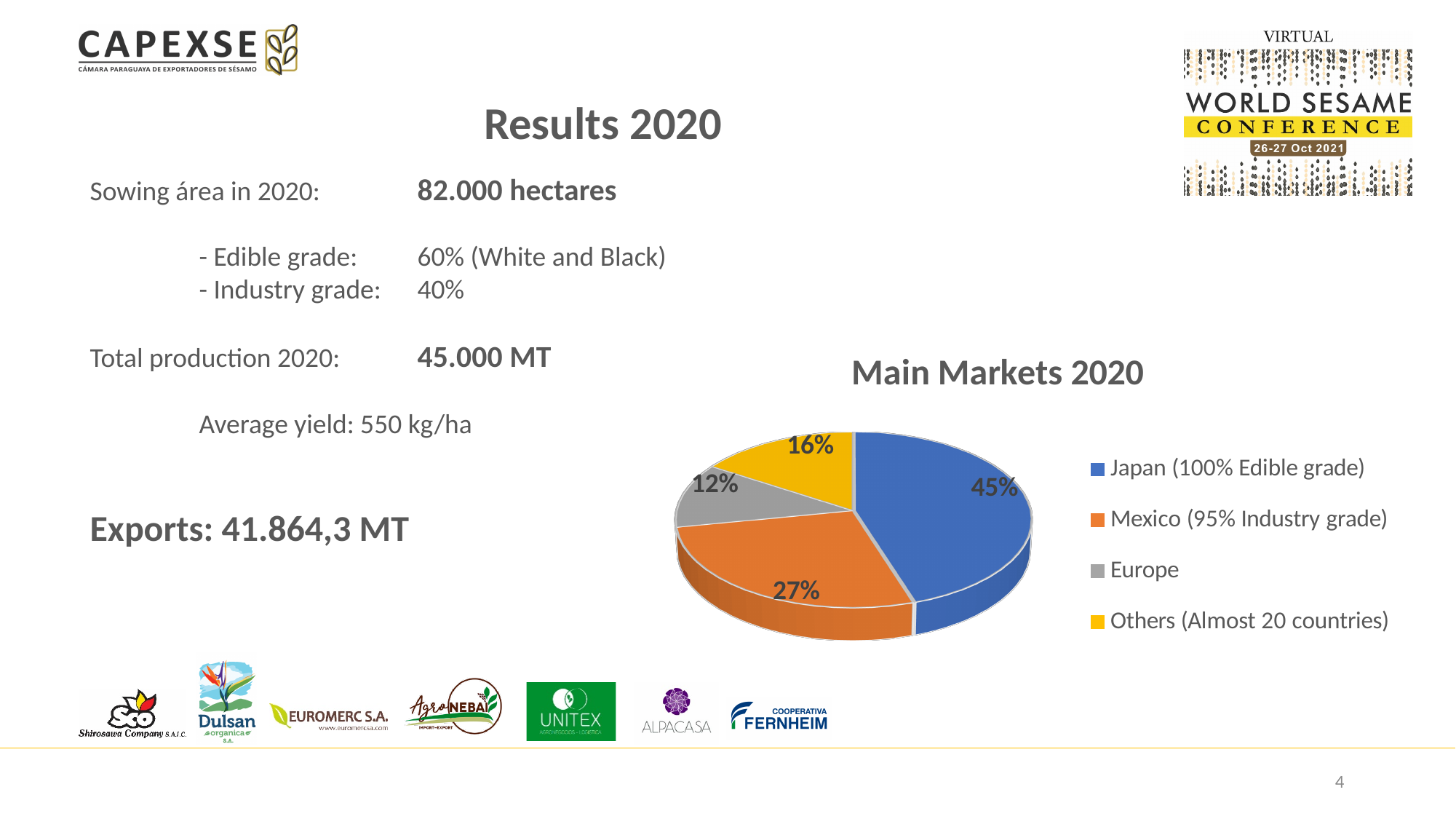
What is the difference in percentage points between the Japan slice and the Mexico slice? 18 What share of the pie does Mexico (95% Industry grade) hold? 27% Which slice is larger, Others (Almost 20 countries) or Europe? Others (Almost 20 countries) Which market has the smallest slice of the pie? Europe What colour is the Europe slice in the pie chart? grey Which market has the largest slice of the pie? Japan (100% Edible grade) How many entries does the legend of the pie chart list? 4 What share of the pie does Japan (100% Edible grade) hold? 45% What type of chart is shown under the title 'Main Markets 2020'? pie chart What share of the pie does Europe hold? 12% How many slices does the pie chart have? 4